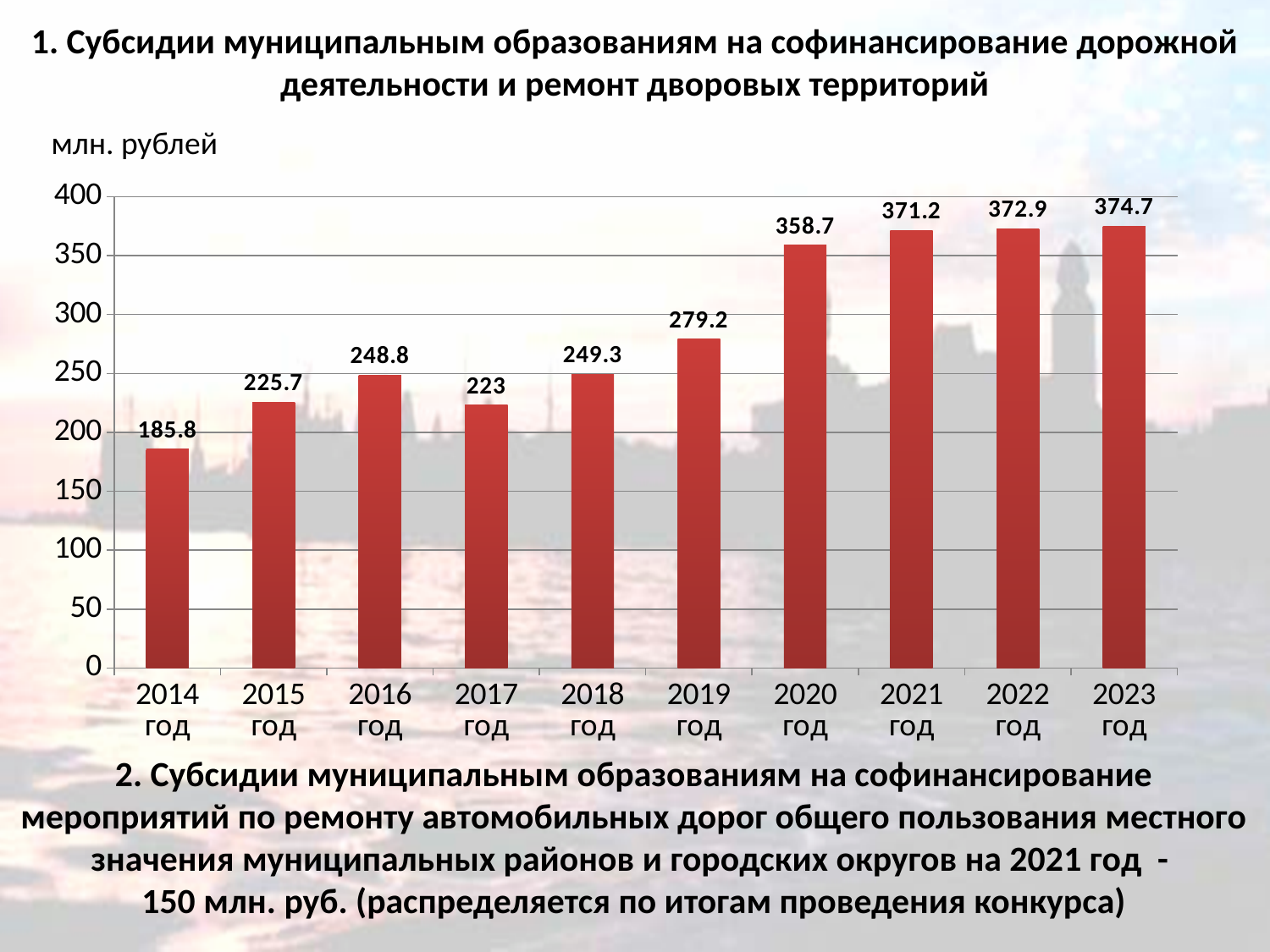
Which year has the lowest value? 2014 год Is the value for 2014 год greater or less than 200? less What unit is indicated for the values on the chart? млн. рублей What kind of chart is shown on the slide? bar chart What is the value for 2017 год? 223 How many years are shown on the x axis? 10 Which is larger, the value for 2019 год or the value for 2017 год? 2019 год What is the difference between the values for 2020 год and 2019 год? 79.5 What is the value for 2014 год? 185.8 What is the difference between the values for 2023 год and 2014 год? 188.9 Which year has the highest value? 2023 год What is the value for 2019 год? 279.2